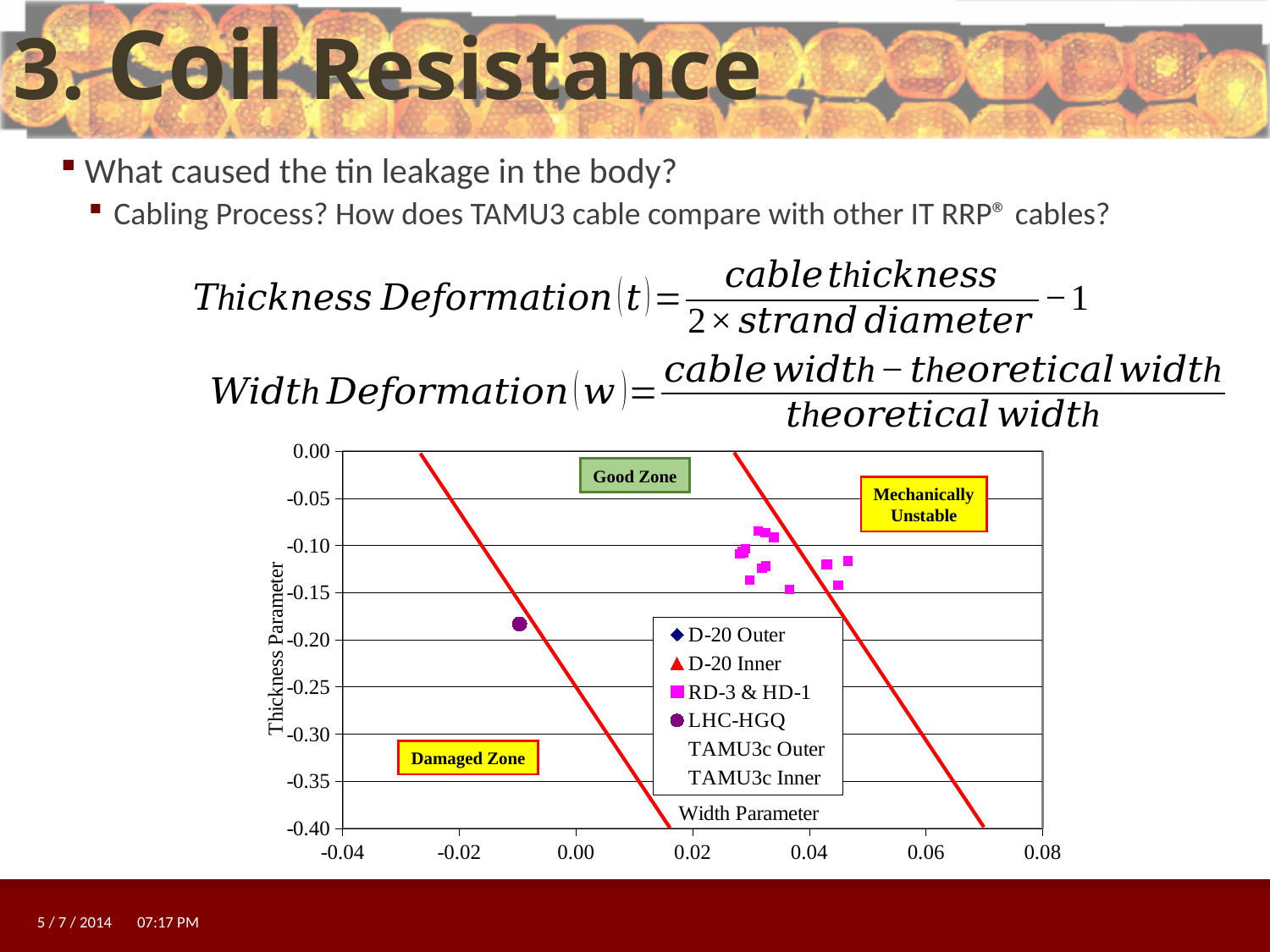
Which plotted series has the highest Thickness Parameter value? RD-3 & HD-1 What kind of chart is shown on the slide? scatter chart Which plotted series has the lowest Thickness Parameter value? LHC-HGQ Is the Thickness Parameter of the LHC-HGQ point greater or less than -0.15? less Are the Width Parameter values of the RD-3 & HD-1 points greater or less than 0.02? greater Are the Thickness Parameter values of the RD-3 & HD-1 points greater or less than -0.20? greater Which series has a larger Width Parameter: LHC-HGQ or RD-3 & HD-1? RD-3 & HD-1 How many series does the chart legend list? 6 Which series in the legend is represented by a purple circle marker? LHC-HGQ What is the label of the vertical axis of the chart? Thickness Parameter What is the label of the horizontal axis of the chart? Width Parameter